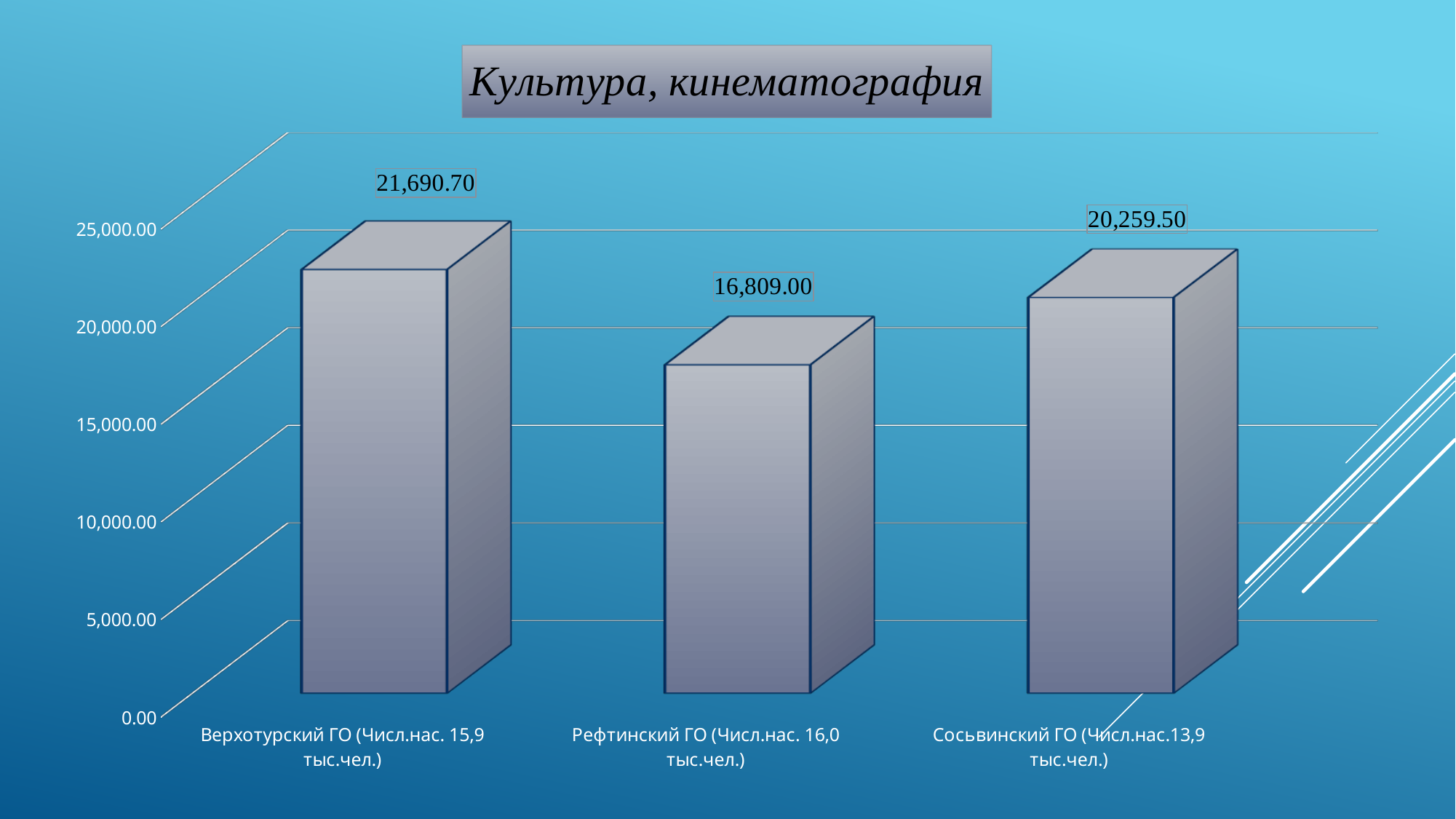
What is the title of the chart? Культура, кинематография What is the difference between the values for Сосьвинский ГО and Рефтинский ГО? 3,450.50 Is the value for Рефтинский ГО greater or less than 20,000.00? less How many categories are shown on the chart? 3 What is the value for Сосьвинский ГО? 20,259.50 What is the value for Верхотурский ГО? 21,690.70 What kind of chart is shown on the slide? bar chart Which category has the lowest value? Рефтинский ГО Which category has the highest value? Верхотурский ГО Which is larger, the value for Сосьвинский ГО or the value for Рефтинский ГО? Сосьвинский ГО What is the difference between the values for Верхотурский ГО and Рефтинский ГО? 4,881.70 What is the value for Рефтинский ГО? 16,809.00